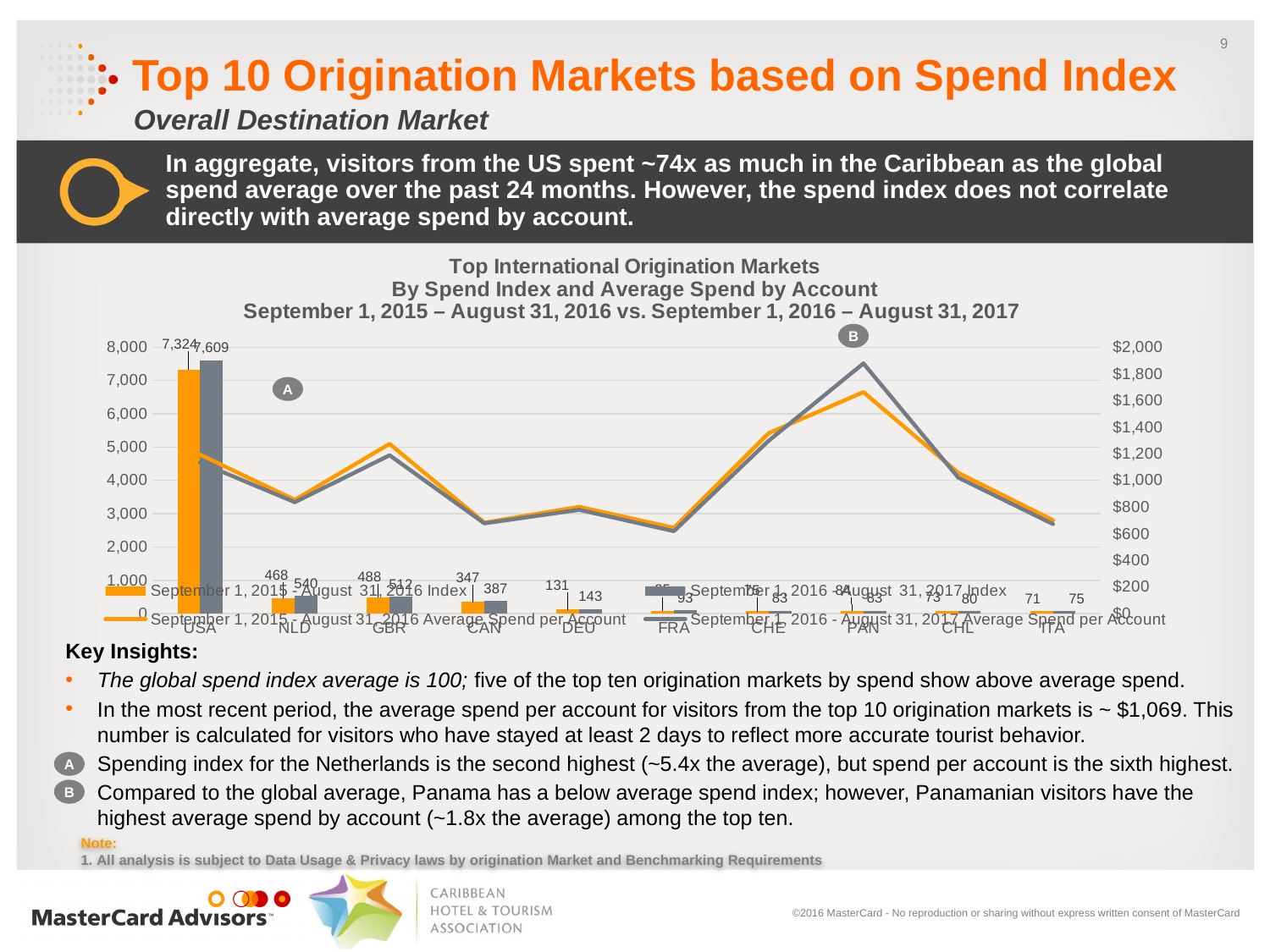
What is the difference between the USA's September 1, 2016 - August 31, 2017 Index and its September 1, 2015 - August 31, 2016 Index? 285 Which origination market has the lowest September 1, 2016 - August 31, 2017 Index? ITA By how much did the NLD Index increase from the September 1, 2015 - August 31, 2016 period to the September 1, 2016 - August 31, 2017 period? 72 Which has the larger September 1, 2016 - August 31, 2017 Index, NLD or GBR? NLD How many series does the chart legend list? 4 What is the September 1, 2016 - August 31, 2017 Index value for USA? 7,609 What is the September 1, 2016 - August 31, 2017 Index value for CAN? 387 Which origination market has the highest September 1, 2016 - August 31, 2017 Index? USA Is the September 1, 2016 - August 31, 2017 Average Spend per Account for PAN greater or less than $1,600? greater Is the September 1, 2016 - August 31, 2017 Average Spend per Account for CAN greater or less than $800? less How many origination markets are shown on the x axis of the chart? 10 What is the September 1, 2015 - August 31, 2016 Index value for NLD? 468